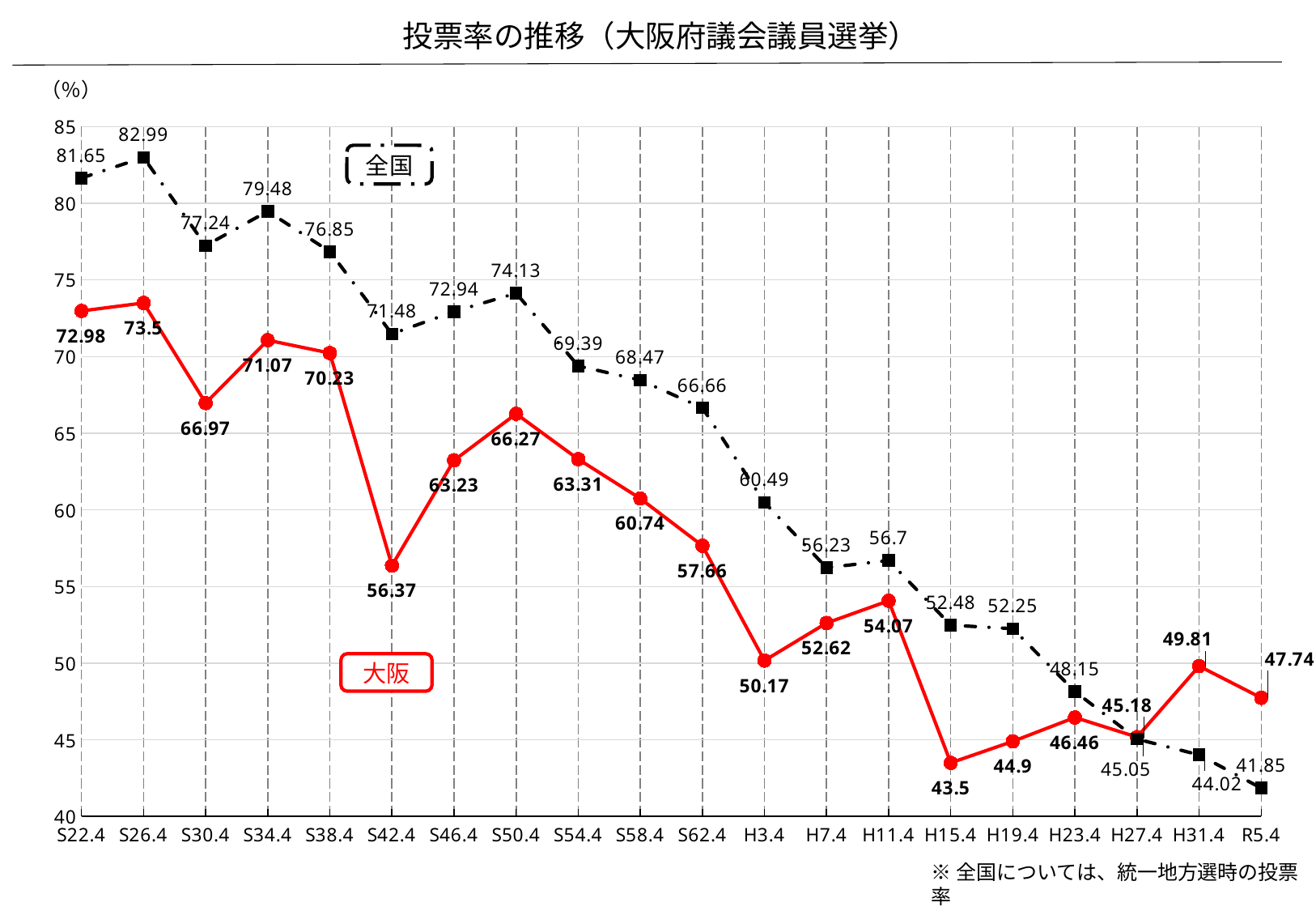
How many series are plotted on the chart? 2 What is the 全国 turnout value at S26.4? 82.99 At which election does the 全国 series reach its highest value? S26.4 What is the 大阪 turnout value at R5.4? 47.74 How many elections (x-axis points) are plotted on the chart? 20 What type of chart is shown? Line chart What is the difference between the 全国 and 大阪 values at S22.4? 8.67 What is the 大阪 turnout value at S42.4? 56.37 Overall, does the 全国 series rise or fall from S22.4 to R5.4? Fall What is the title of the chart? 投票率の推移（大阪府議会議員選挙） At which election does the 大阪 series reach its lowest value? H15.4 At H31.4, which series has the higher value, 全国 or 大阪? 大阪